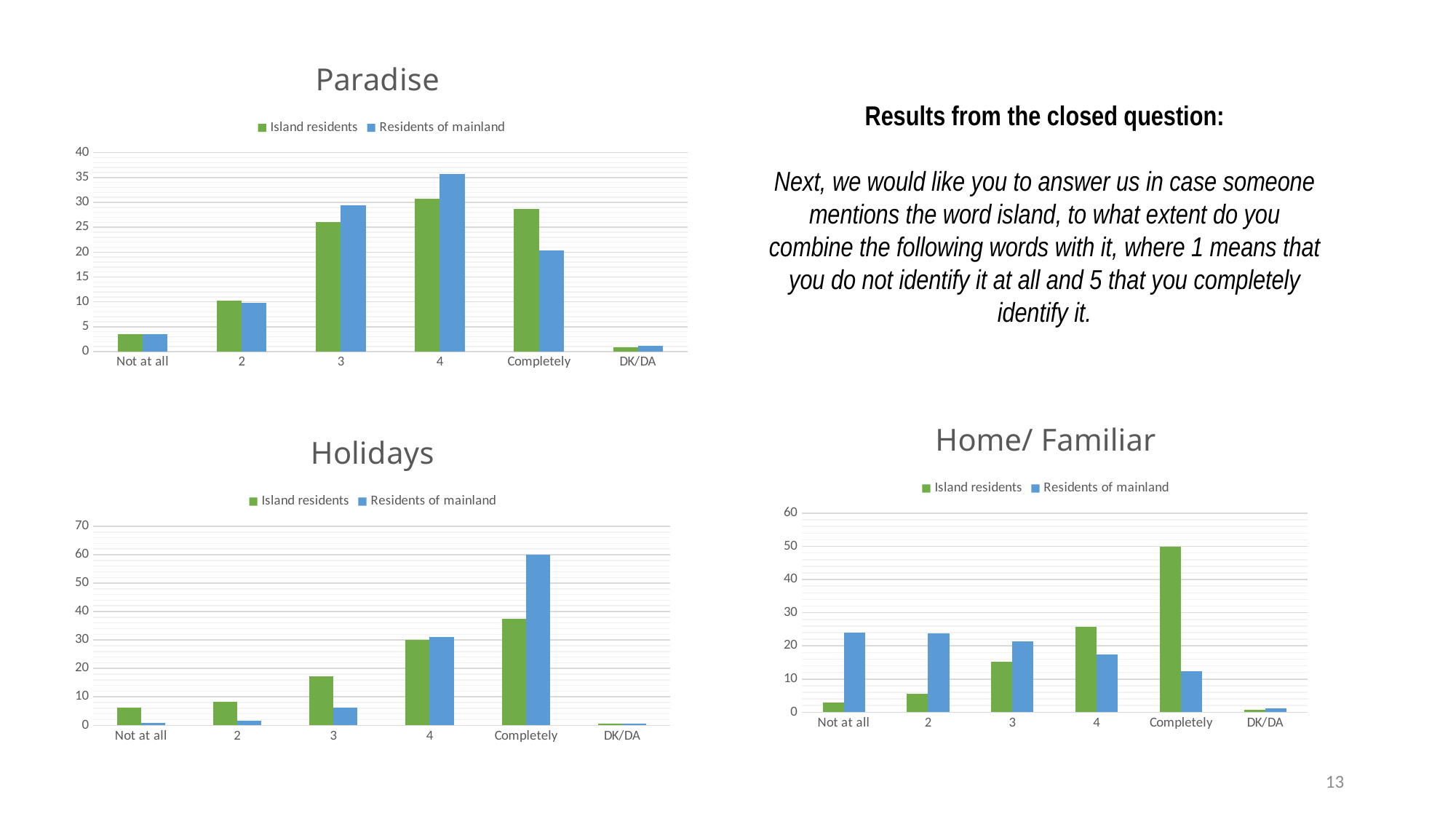
What kind of chart is the Paradise chart? bar chart In the Holidays chart, is the value for Residents of mainland at Completely greater or less than 50? greater How many categories are shown on the x axis of the Home/ Familiar chart? 6 How many series does the legend of the Holidays chart list? 2 In the Paradise chart, is the value for Residents of mainland at category 4 greater or less than 30? greater In the Holidays chart, for category 3, which series has the larger value: Island residents or Residents of mainland? Island residents In the Home/ Familiar chart, which category has the highest value for Island residents? Completely In the Paradise chart, which category has the lowest value for Island residents? DK/DA In the Paradise chart, for the Completely category, which series has the larger value: Island residents or Residents of mainland? Island residents In the Paradise chart, which category has the highest value for Residents of mainland? 4 In the Holidays chart, which category has the highest value for Residents of mainland? Completely In the Home/ Familiar chart, for the Not at all category, which series has the larger value: Island residents or Residents of mainland? Residents of mainland